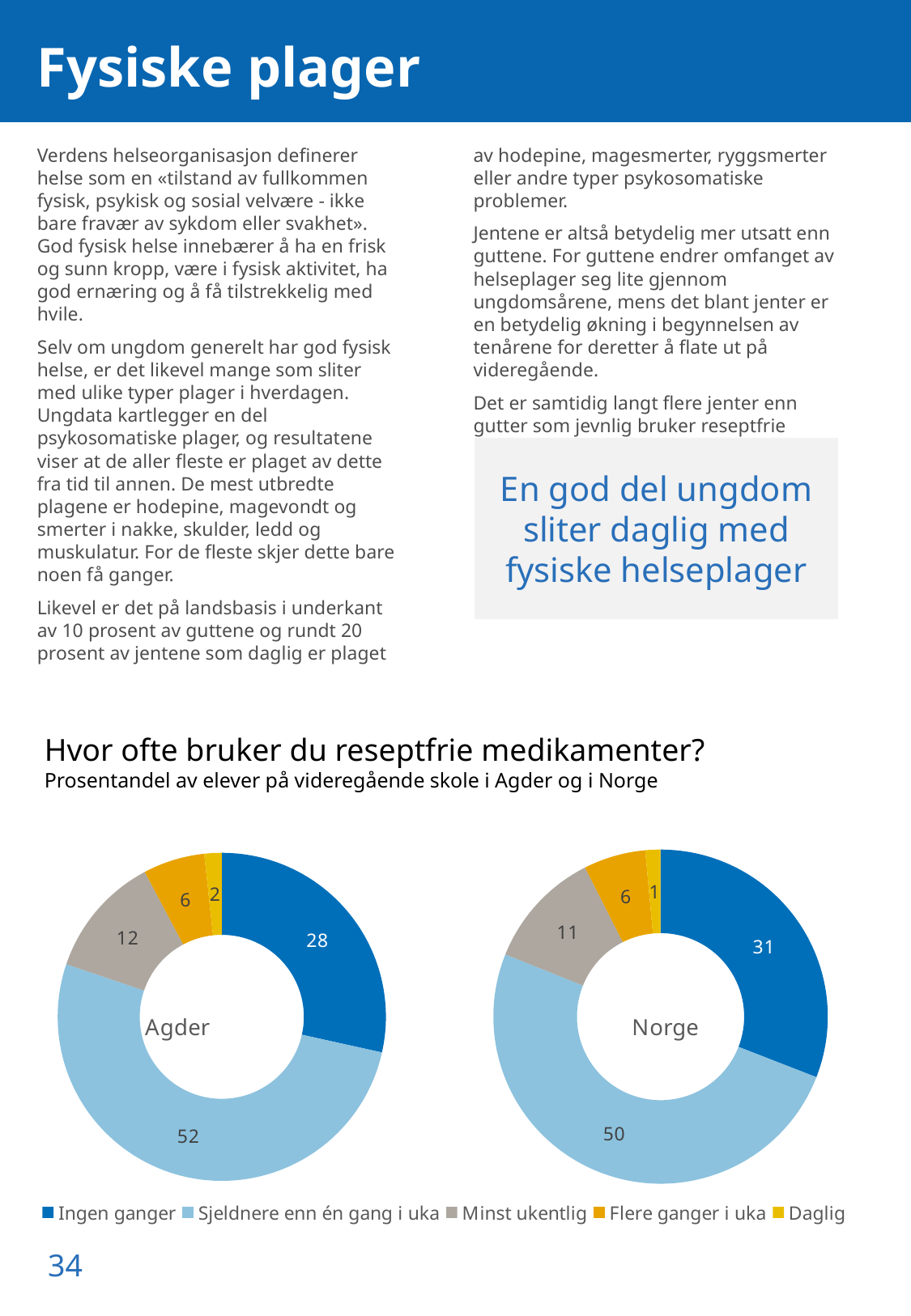
In the Agder chart, what is the value for "Daglig"? 2 In the Norge chart, what is the value for "Minst ukentlig"? 11 What is the title of the chart section on the slide? Hvor ofte bruker du reseptfrie medikamenter? Which is larger: "Minst ukentlig" in the Agder chart or "Minst ukentlig" in the Norge chart? Agder In the Norge chart, what is the value for "Ingen ganger"? 31 How many categories does the legend list for the charts? 5 What kind of chart is used to show the Agder and Norge data? Pie (donut) chart What is the difference between the "Ingen ganger" values in the Norge chart and the Agder chart? 3 In the Agder chart, which category has the largest share? Sjeldnere enn én gang i uka In the Agder chart, what is the value for "Flere ganger i uka"? 6 In the Norge chart, which category has the smallest share? Daglig In the Agder chart, what is the value for "Sjeldnere enn én gang i uka"? 52